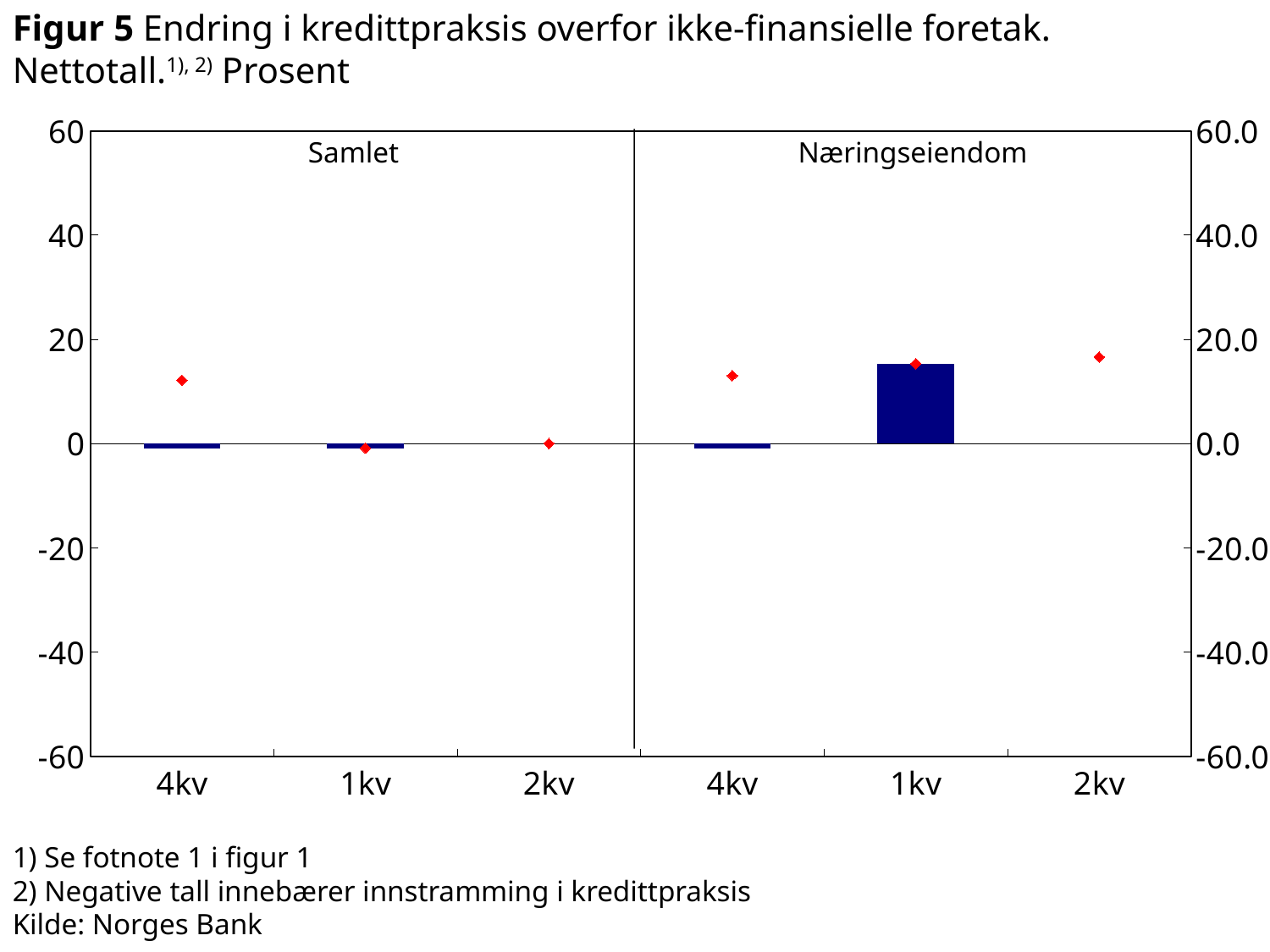
What is the maximum value shown on the left vertical axis? 60 Which bar is larger: 1kv in the Samlet panel or 1kv in the Næringseiendom panel? 1kv in the Næringseiendom panel In the Næringseiendom panel, which quarter has the tallest bar? 1kv Is the red marker for 4kv in the Samlet panel greater or less than 20? less Is the red marker for 4kv in the Samlet panel greater or less than 0? greater Is the bar for 1kv in the Næringseiendom panel greater or less than 0? greater How many quarters are shown on the x axis of the Samlet panel? 3 What are the names of the two panels in the chart? Samlet and Næringseiendom Do the red markers in the Næringseiendom panel rise or fall from 4kv to 2kv? rise What kind of chart is shown in Figur 5? combination bar and line chart (bars with red diamond markers)